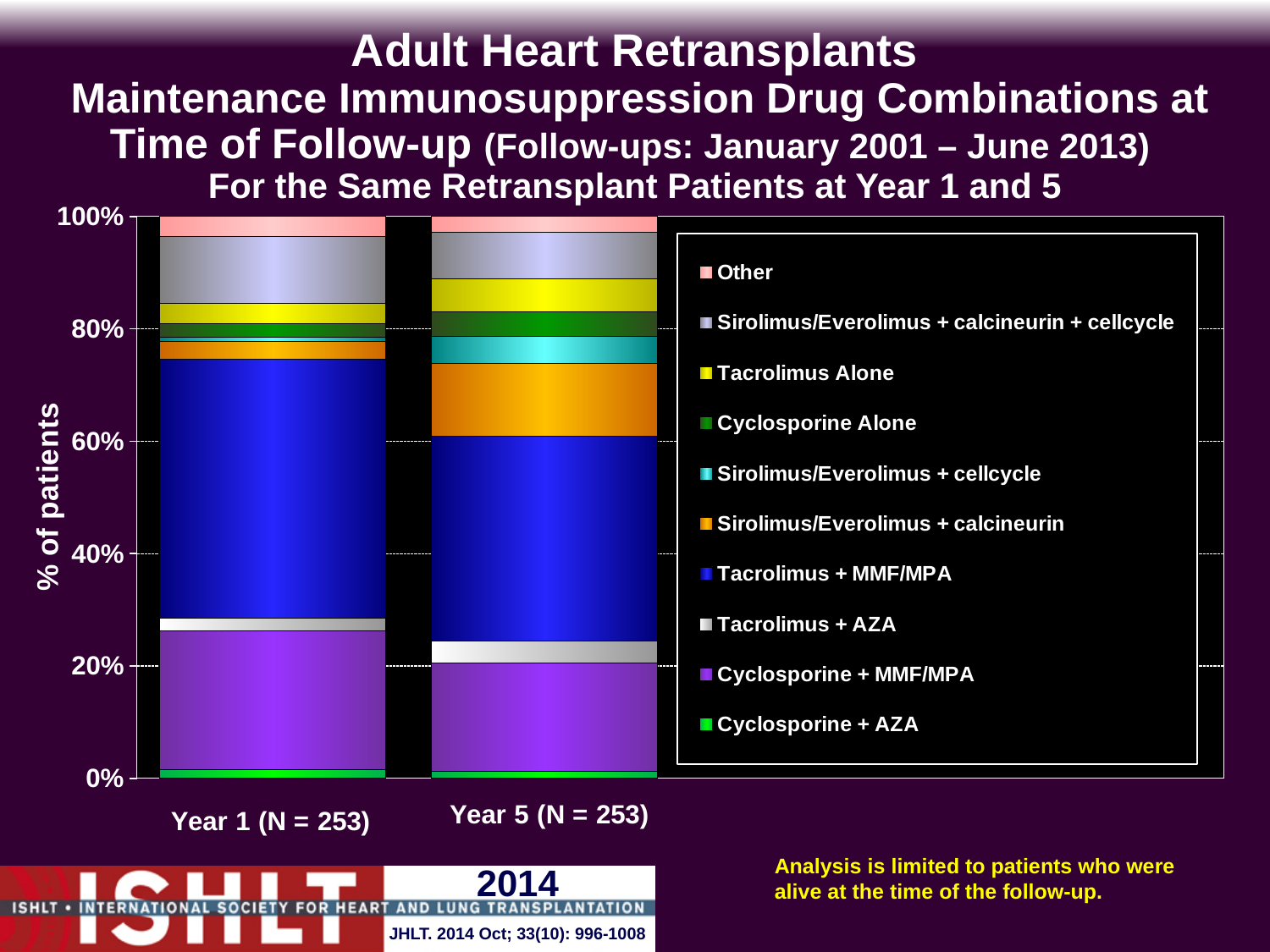
Is the Tacrolimus + MMF/MPA share of patients larger at Year 1 or at Year 5? Year 1 Is the Sirolimus/Everolimus + calcineurin share of patients at Year 5 greater or less than 20%? less Which drug combination makes up the largest segment of the Year 1 bar? Tacrolimus + MMF/MPA What is the N (number of patients) shown for the Year 5 bar? 253 What kind of chart is shown on the slide? Stacked bar chart Which drug combination makes up the largest segment of the Year 5 bar? Tacrolimus + MMF/MPA What is the label on the vertical axis of the chart? % of patients How many bars (follow-up time points) are plotted in the chart? 2 Is the Tacrolimus + MMF/MPA share of patients at Year 1 greater or less than 40%? greater How many drug combination series does the legend list? 10 Is the Sirolimus/Everolimus + calcineurin share of patients larger at Year 1 or at Year 5? Year 5 Is the Cyclosporine + MMF/MPA share of patients larger at Year 1 or at Year 5? Year 1